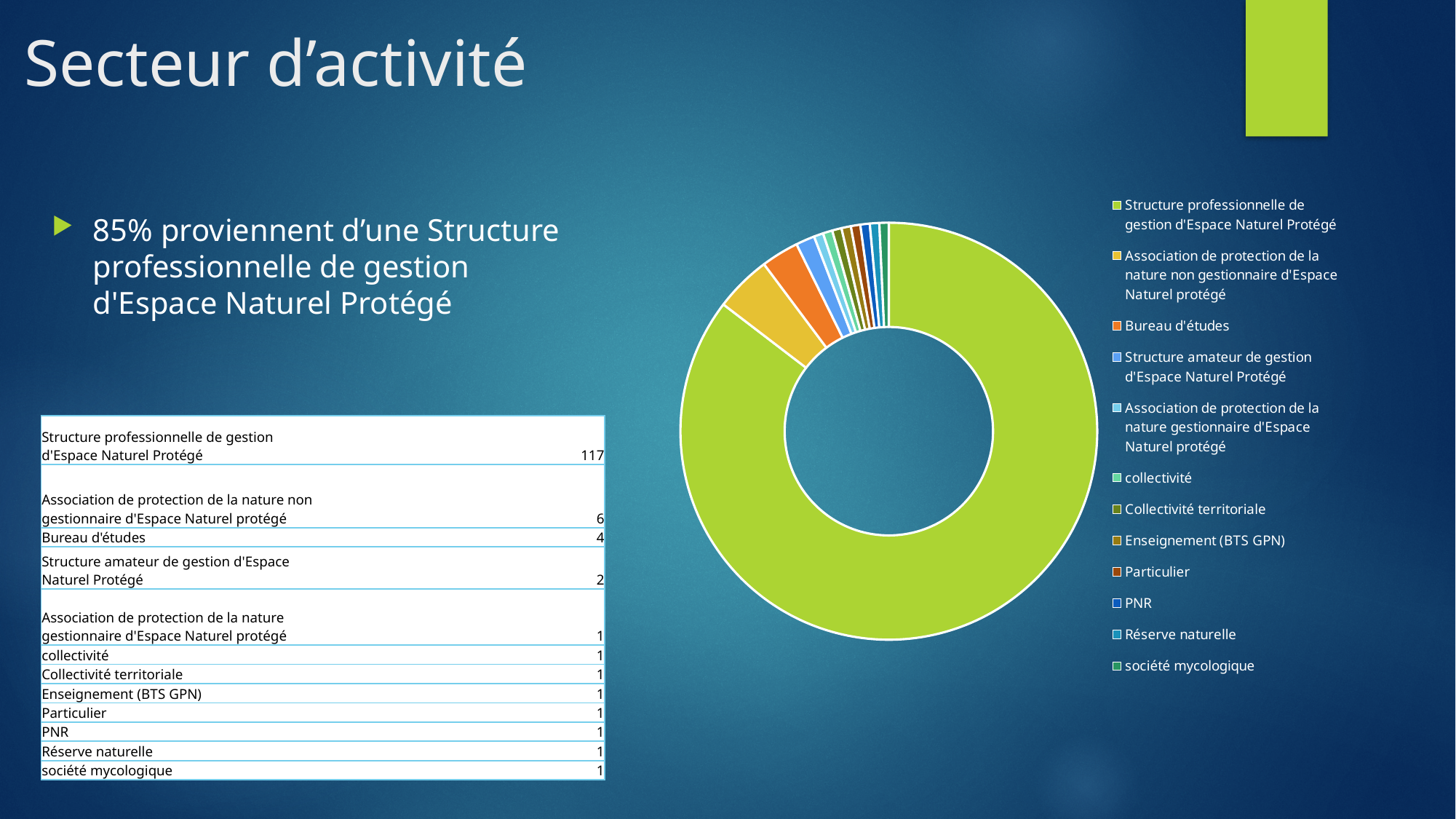
What is the value for Structure professionnelle de gestion d'Espace Naturel Protégé? 117 What colour is the slice for Bureau d'études? orange What share of the total does Structure professionnelle de gestion d'Espace Naturel Protégé represent, according to the slide? 85% How many categories does the chart's legend list? 12 What is the difference between the value for Association de protection de la nature non gestionnaire d'Espace Naturel protégé and the value for Bureau d'études? 2 What is the value for Structure amateur de gestion d'Espace Naturel Protégé? 2 Which category has the largest slice in the chart? Structure professionnelle de gestion d'Espace Naturel Protégé Which is larger, the value for Bureau d'études or the value for Structure amateur de gestion d'Espace Naturel Protégé? Bureau d'études What is the value for PNR? 1 What is the value for Bureau d'études? 4 What kind of chart is shown on the slide? doughnut chart What is the value for Association de protection de la nature non gestionnaire d'Espace Naturel protégé? 6